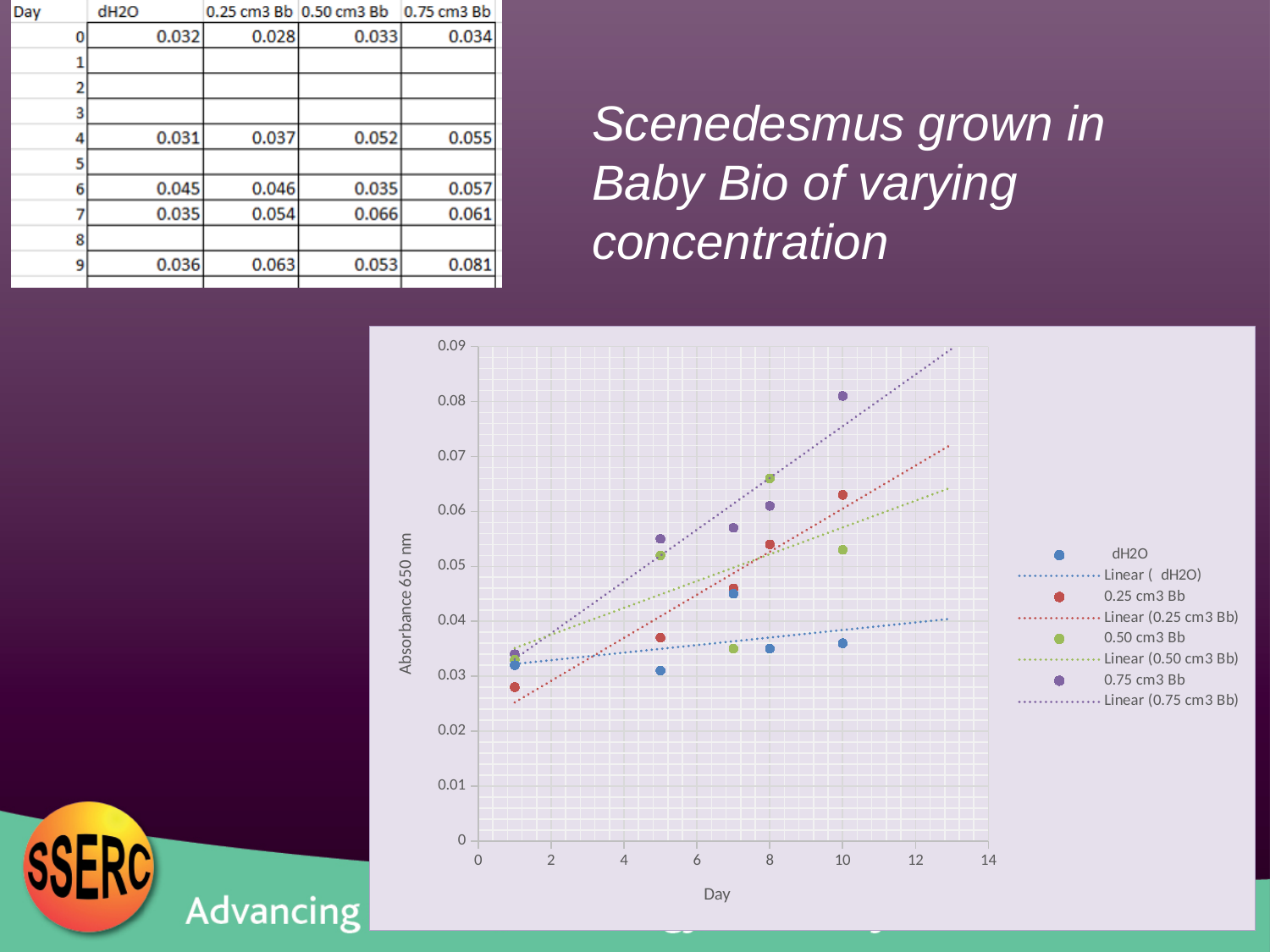
Which series has the highest plotted point on the chart? 0.75 cm3 Bb Are all plotted values for the dH2O series greater or less than 0.05? less What is the label of the chart's horizontal axis? Day How many data points are plotted for the dH2O series? 5 According to the data table on the slide, which is larger on day 6: the 0.25 cm3 Bb value or the 0.50 cm3 Bb value? 0.25 cm3 Bb Does the dotted trendline for the 0.75 cm3 Bb series rise or fall as Day increases? rise What kind of chart is shown on the slide? scatter chart According to the data table on the slide, what is the absorbance for 0.75 cm3 Bb on day 9? 0.081 What is the label of the chart's vertical axis? Absorbance 650 nm According to the data table on the slide, what is the difference between the 0.75 cm3 Bb and dH2O absorbance values on day 9? 0.045 Is the highest plotted value for the 0.75 cm3 Bb series greater or less than 0.07? greater How many entries does the chart's legend list? 8